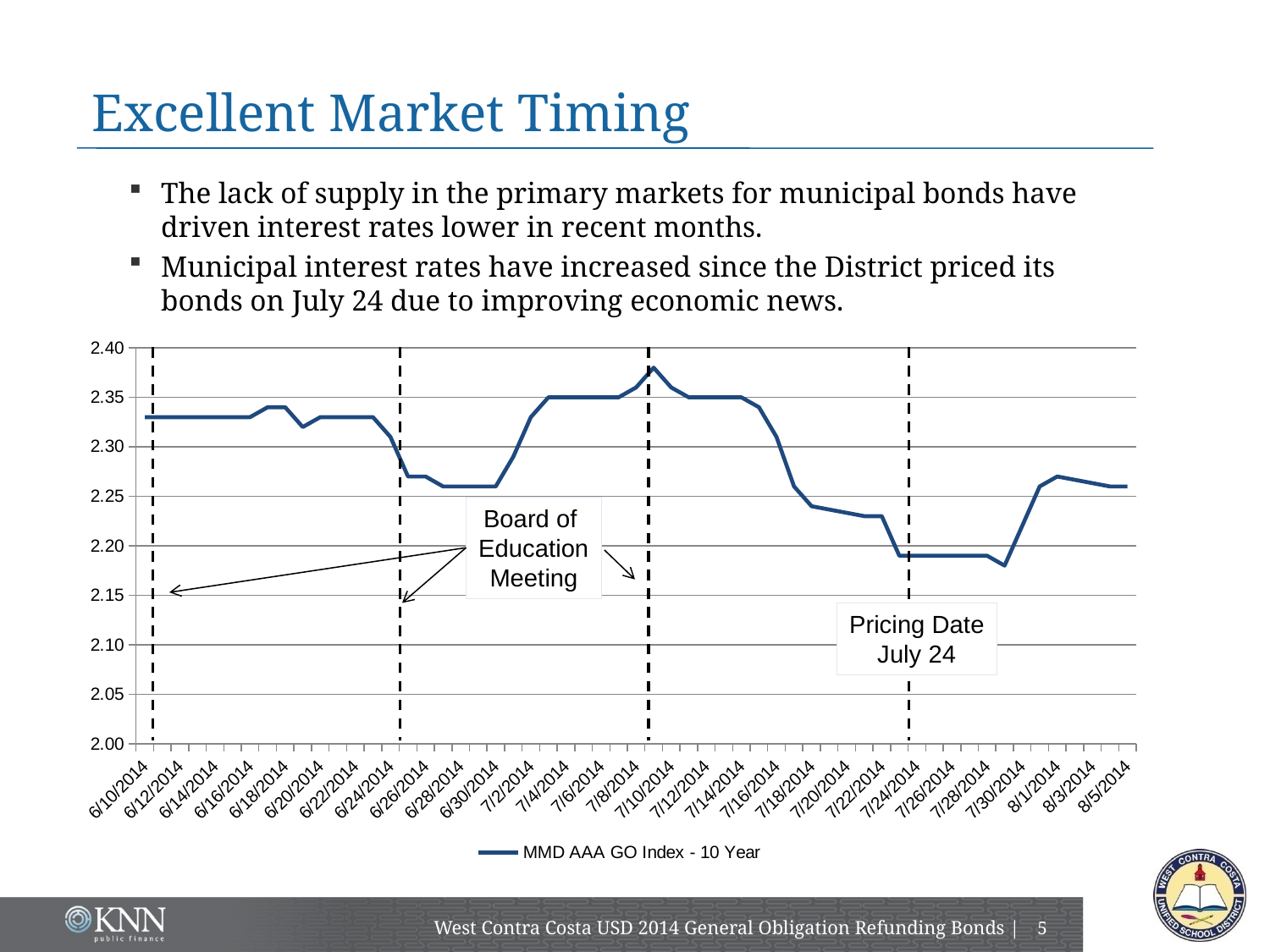
How many series does the chart legend list? 1 Is the value for 7/14/2014 greater or less than 2.30? greater What is the name of the series plotted in the chart? MMD AAA GO Index - 10 Year Is the value for 6/10/2014 greater or less than 2.30? greater Do the values rise or fall between 7/10/2014 and 7/24/2014? fall What date does the 'Pricing Date' annotation on the chart give? July 24 Is the value for 6/28/2014 greater or less than 2.30? less What kind of chart is shown on the slide? line chart Is the value for 7/10/2014 larger or smaller than the value for 7/24/2014? larger